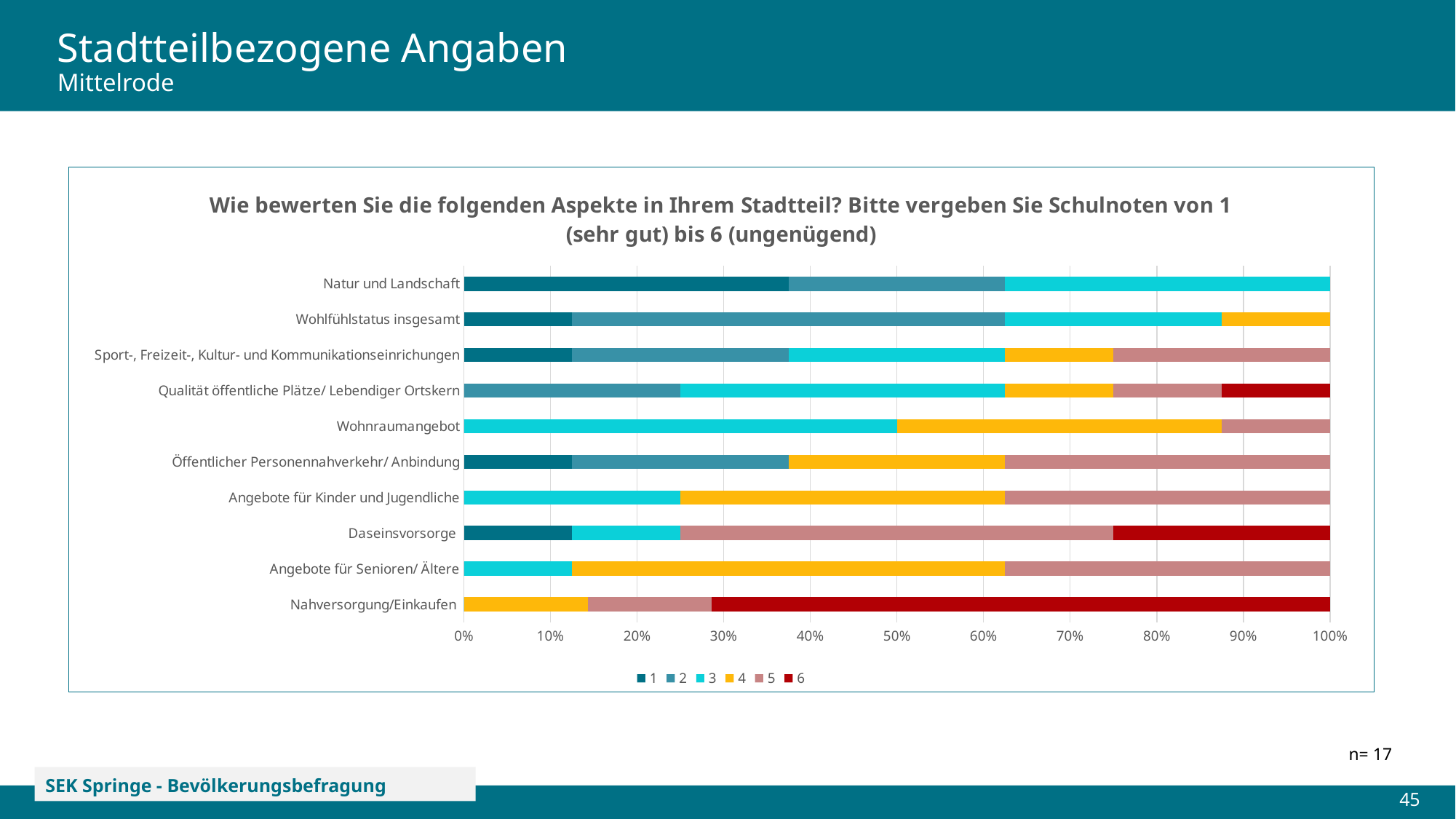
Is the share of grade 6 for Nahversorgung/Einkaufen greater or less than 60%? greater Which category has the largest share of grade 6 (dark red)? Nahversorgung/Einkaufen What kind of chart is shown on the slide? Stacked bar chart Is the share of grade 1 for Natur und Landschaft greater or less than 40%? less Is the share of grade 3 for Wohnraumangebot greater or less than 40%? greater How many series does the legend of the chart list? 6 How many categories (aspects) are listed on the vertical axis of the chart? 10 Which category has the largest share of grade 5 (rose)? Daseinsvorsorge What is the value of n given on the slide? n= 17 What is the total of the stacked bar for Natur und Landschaft? 100% Which is larger: the share of grade 1 for Natur und Landschaft or the share of grade 1 for Wohlfühlstatus insgesamt? Natur und Landschaft Which category has the largest share of grade 1 (dark teal)? Natur und Landschaft